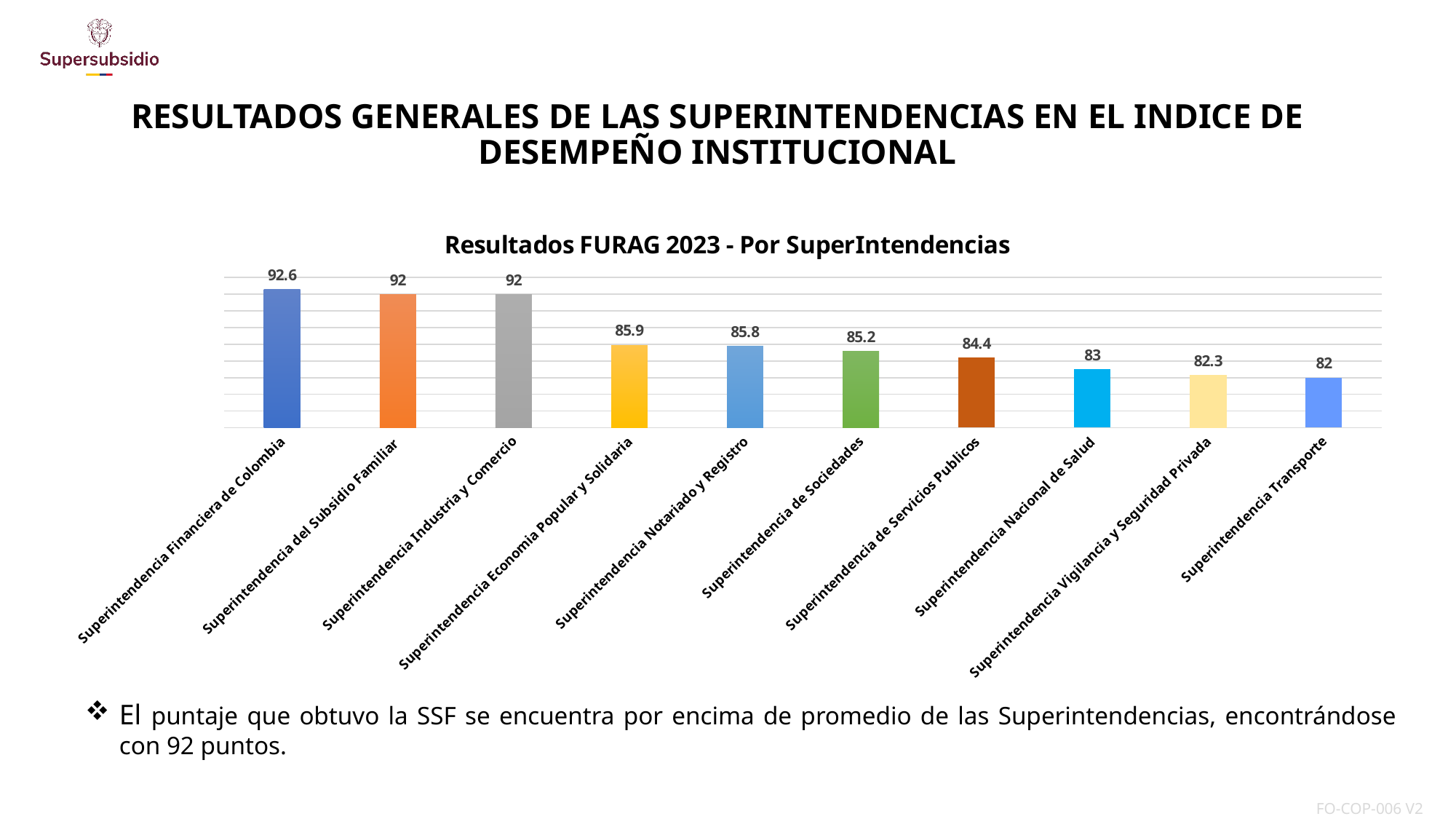
What kind of chart is shown on the slide? Bar chart What is the difference between the values for Superintendencia Financiera de Colombia and Superintendencia Transporte? 10.6 What is the value for Superintendencia Financiera de Colombia? 92.6 What is the value for Superintendencia de Sociedades? 85.2 Which is larger, the value for Superintendencia Notariado y Registro or the value for Superintendencia de Servicios Publicos? Superintendencia Notariado y Registro What is the value for Superintendencia del Subsidio Familiar? 92 How many superintendencias are shown in the chart? 10 What is the title of the chart? Resultados FURAG 2023 - Por SuperIntendencias Which superintendencia has the lowest value? Superintendencia Transporte What is the value for Superintendencia Vigilancia y Seguridad Privada? 82.3 Which superintendencia has the highest value? Superintendencia Financiera de Colombia What is the difference between the values for Superintendencia Economia Popular y Solidaria and Superintendencia Nacional de Salud? 2.9